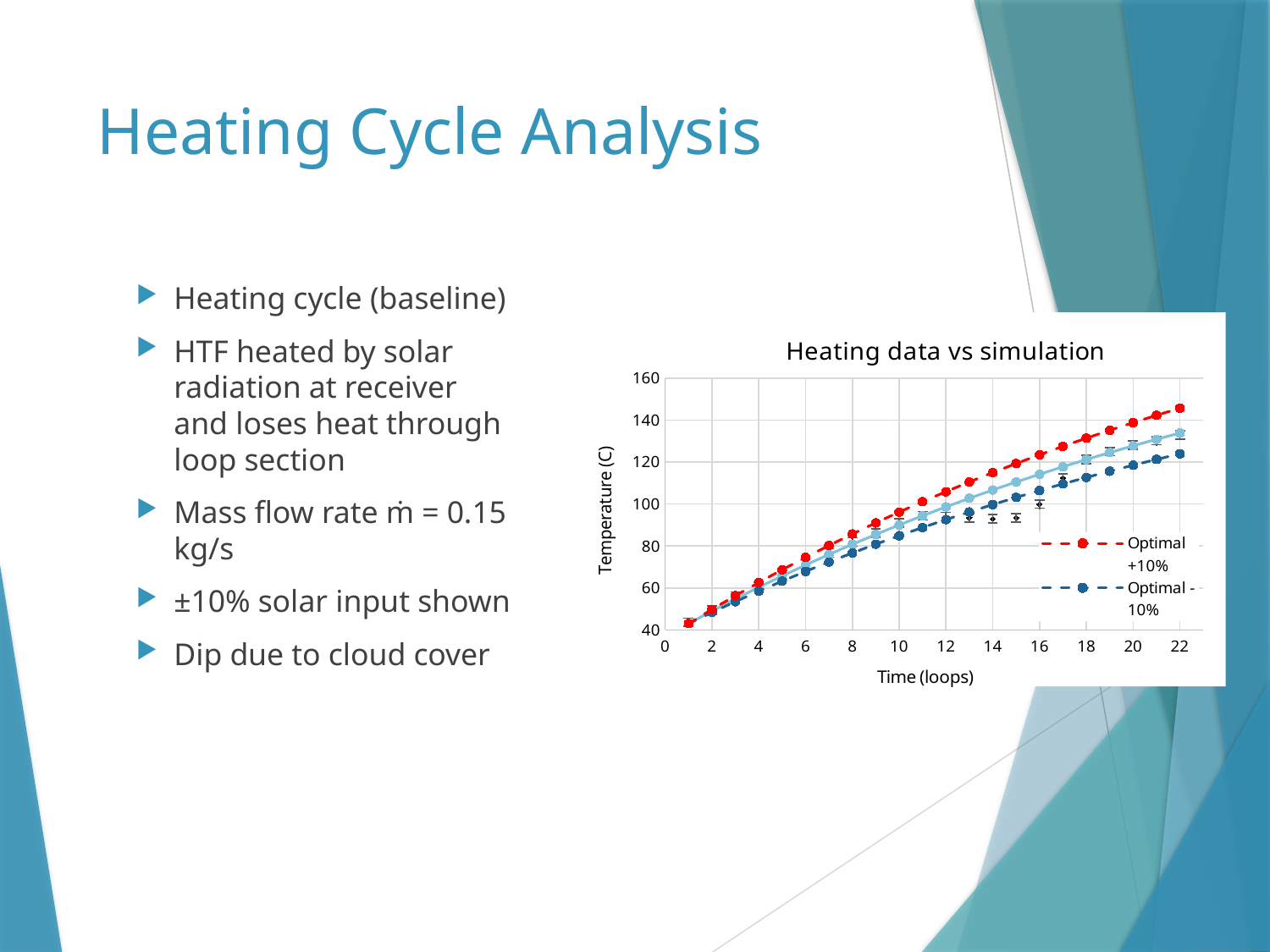
Is the value for Optimal +10% at time 12 greater or less than 100? greater What kind of chart is shown on the slide? line chart What is the label of the vertical axis of the chart? Temperature (C) What is the highest value shown on the Time (loops) axis? 22 Which series is drawn in red on the chart? Optimal +10% Is the value for Optimal -10% at time 22 greater or less than 140? less At time 22, which series has the higher temperature, Optimal +10% or Optimal -10%? Optimal +10% Do the temperature values rise or fall as time (loops) increases? rise Is the value for Optimal -10% at time 22 greater or less than 120? greater